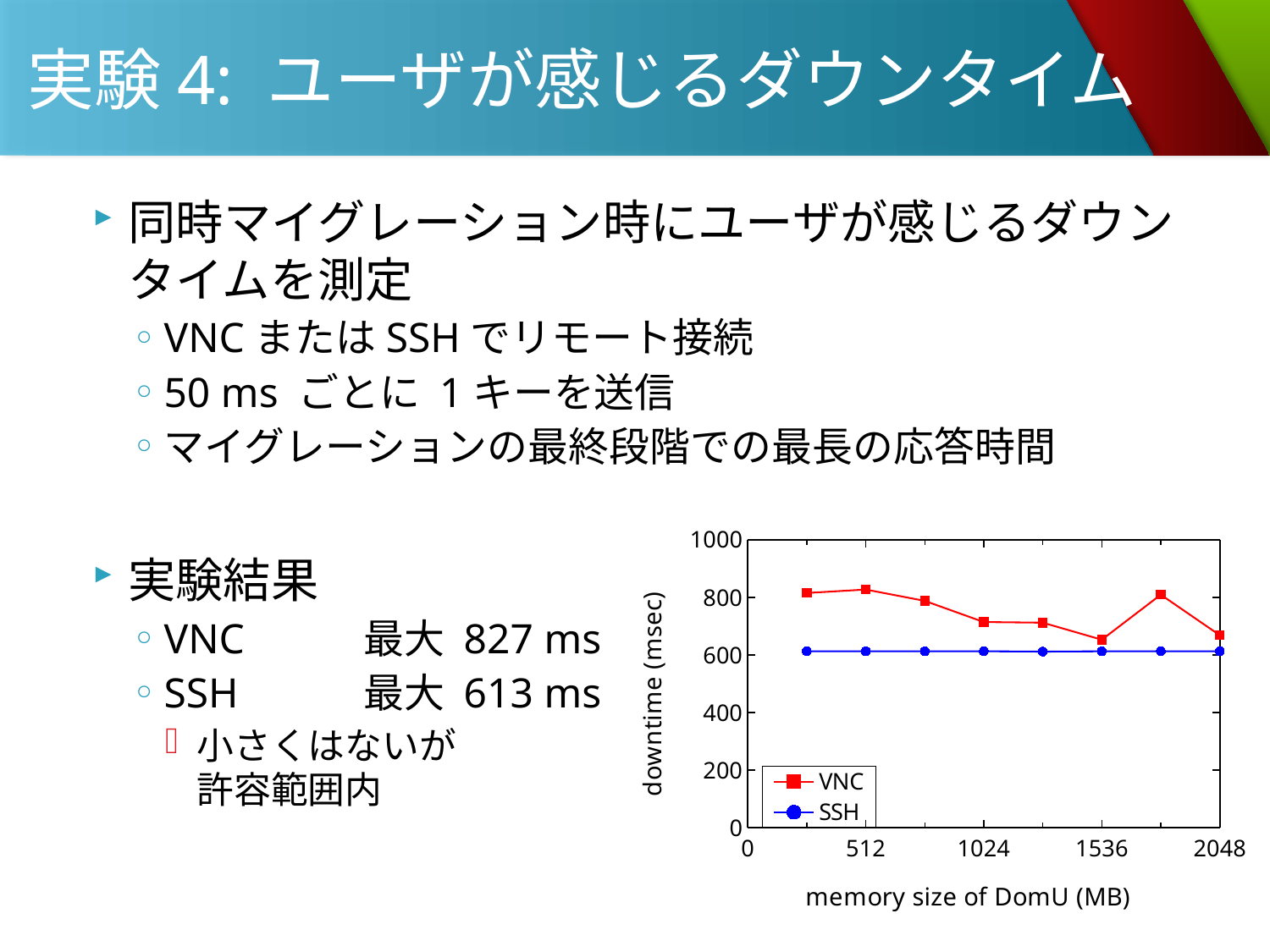
Is the VNC downtime at a memory size of 512 MB greater or less than 800 msec? greater Does the SSH downtime rise, fall, or stay roughly constant as memory size increases? stays roughly constant Is the SSH downtime at a memory size of 1024 MB greater or less than 800 msec? less What is the label of the x axis of the chart? memory size of DomU (MB) What are the two series named in the chart's legend? VNC and SSH How many series does the chart's legend list? 2 At a memory size of 1024 MB, which series has the larger downtime, VNC or SSH? VNC Is the VNC downtime at a memory size of 2048 MB greater or less than 600 msec? greater What kind of chart is shown on the slide? line chart Which series shows the higher downtime across all memory sizes? VNC How many data points are plotted for the VNC series? 8